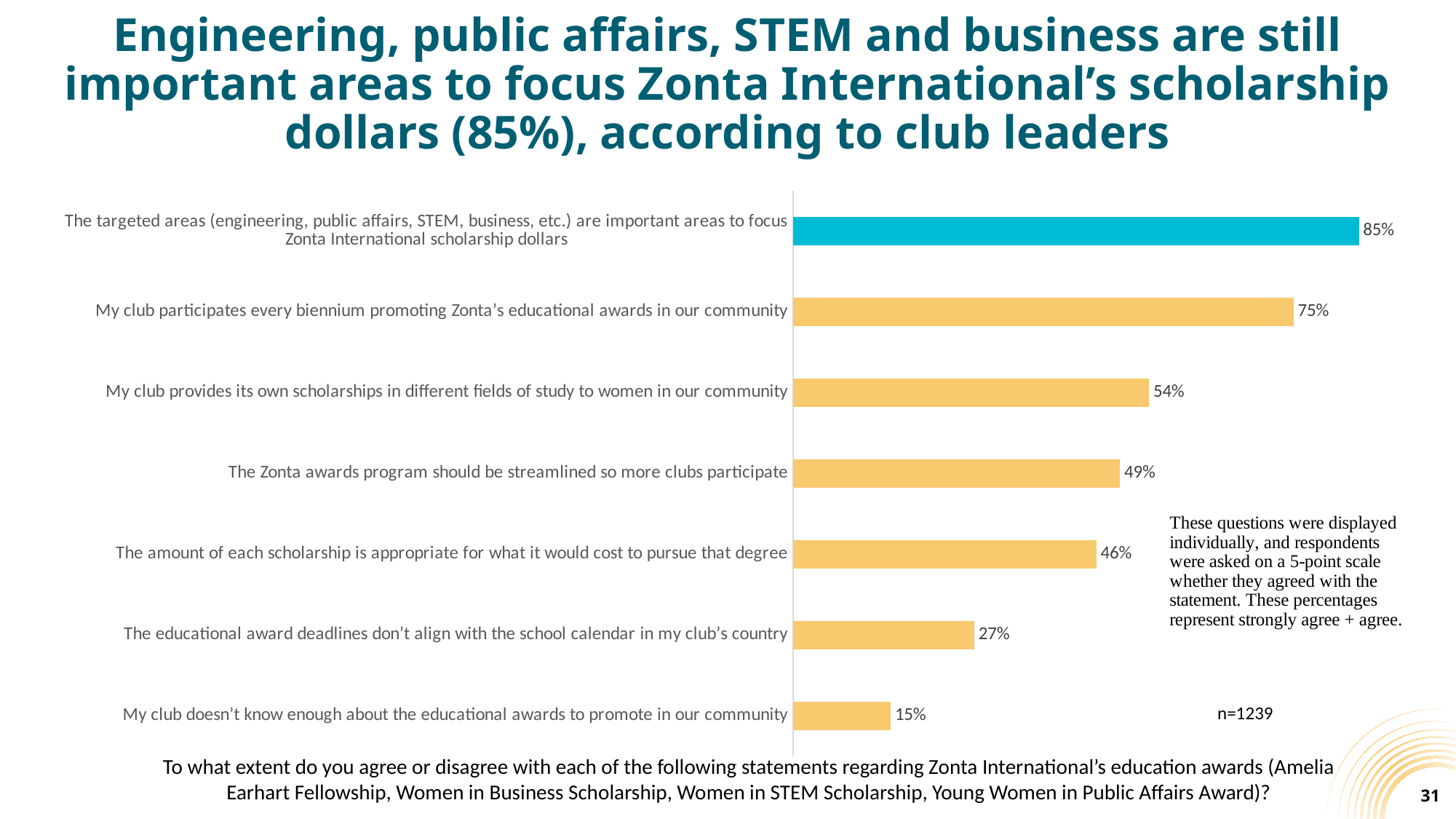
What percentage agree that the Zonta awards program should be streamlined so more clubs participate? 49% Which bar in the chart is coloured differently (blue) from the others? The targeted areas (engineering, public affairs, STEM, business, etc.) are important areas to focus Zonta International scholarship dollars Which statement has the highest percentage of agreement? The targeted areas (engineering, public affairs, STEM, business, etc.) are important areas to focus Zonta International scholarship dollars What percentage of club leaders agree that the targeted areas (engineering, public affairs, STEM, business, etc.) are important areas to focus Zonta International scholarship dollars? 85% What is the sample size (n) shown on the slide? n=1239 How many statements are shown in the chart? 7 What type of chart is shown on the slide? Bar chart Which statement has the lowest percentage of agreement? My club doesn't know enough about the educational awards to promote in our community What percentage agree that their club participates every biennium promoting Zonta's educational awards in their community? 75% What is the difference in percentage points between the statement about clubs providing their own scholarships (54%) and the statement about the amount of each scholarship being appropriate (46%)? 8 percentage points Which has a higher agreement percentage: the statement that the Zonta awards program should be streamlined, or the statement that the amount of each scholarship is appropriate? The Zonta awards program should be streamlined so more clubs participate What percentage agree that the educational award deadlines don't align with the school calendar in their club's country? 27%